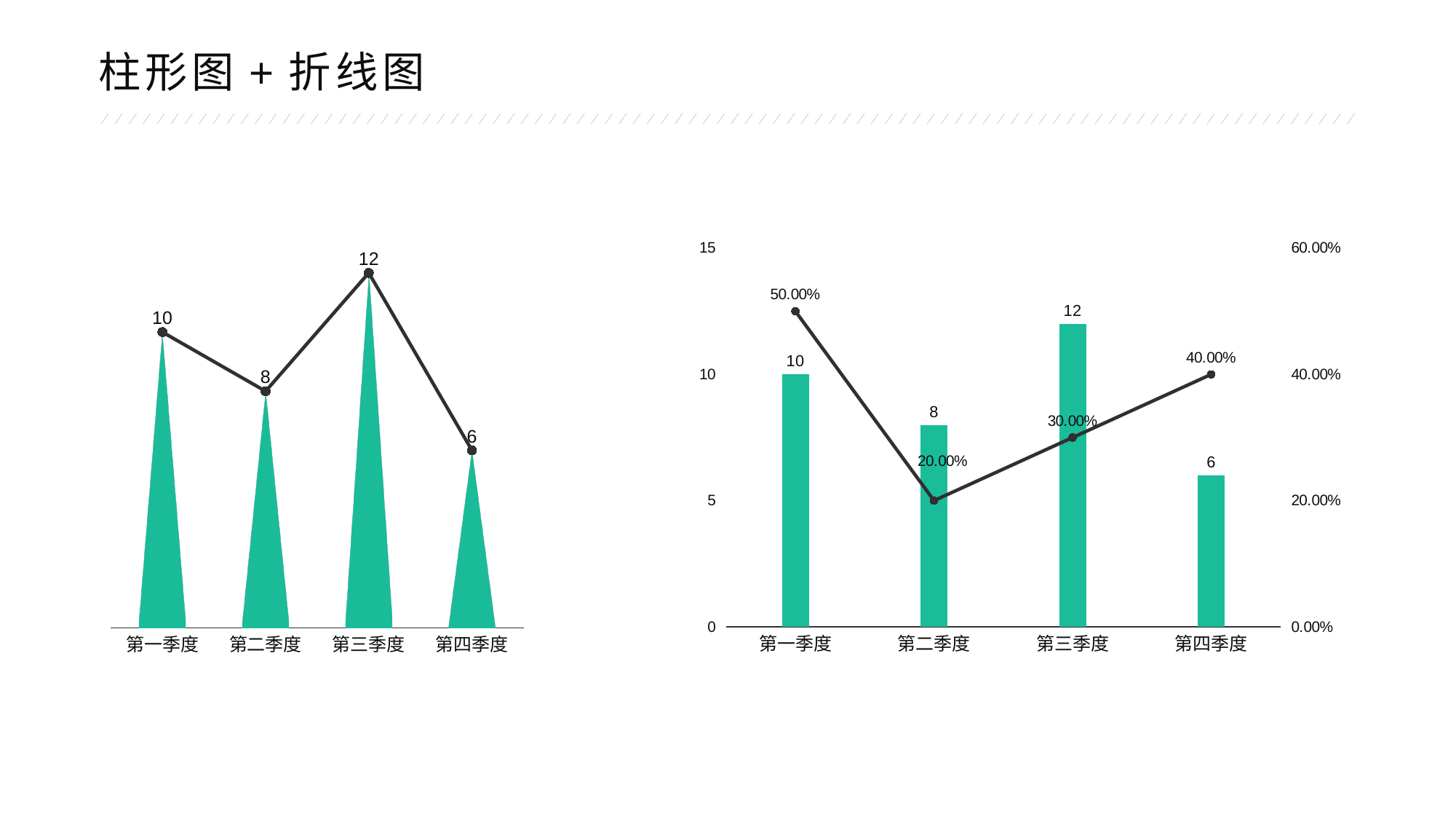
In the chart on the right, does the line value rise or fall from 第二季度 to 第四季度? rise How many categories are shown on the x axis of the chart on the right? 4 In the chart on the right, which category has the lowest bar value? 第四季度 In the chart on the right, what is the difference between the bar values for 第三季度 and 第四季度? 6 In the chart on the right, what is the line value for 第一季度? 50.00% In the chart on the left, which is larger, the value for 第一季度 or the value for 第二季度? 第一季度 In the chart on the right, what is the difference between the line values for 第一季度 and 第二季度? 30.00% In the chart on the right, which category has the lowest line value? 第二季度 In the chart on the left, what is the value for 第二季度? 8 In the chart on the right, what is the line value for 第四季度? 40.00% In the chart on the left, which category has the highest value? 第三季度 In the chart on the right, what is the bar value for 第三季度? 12